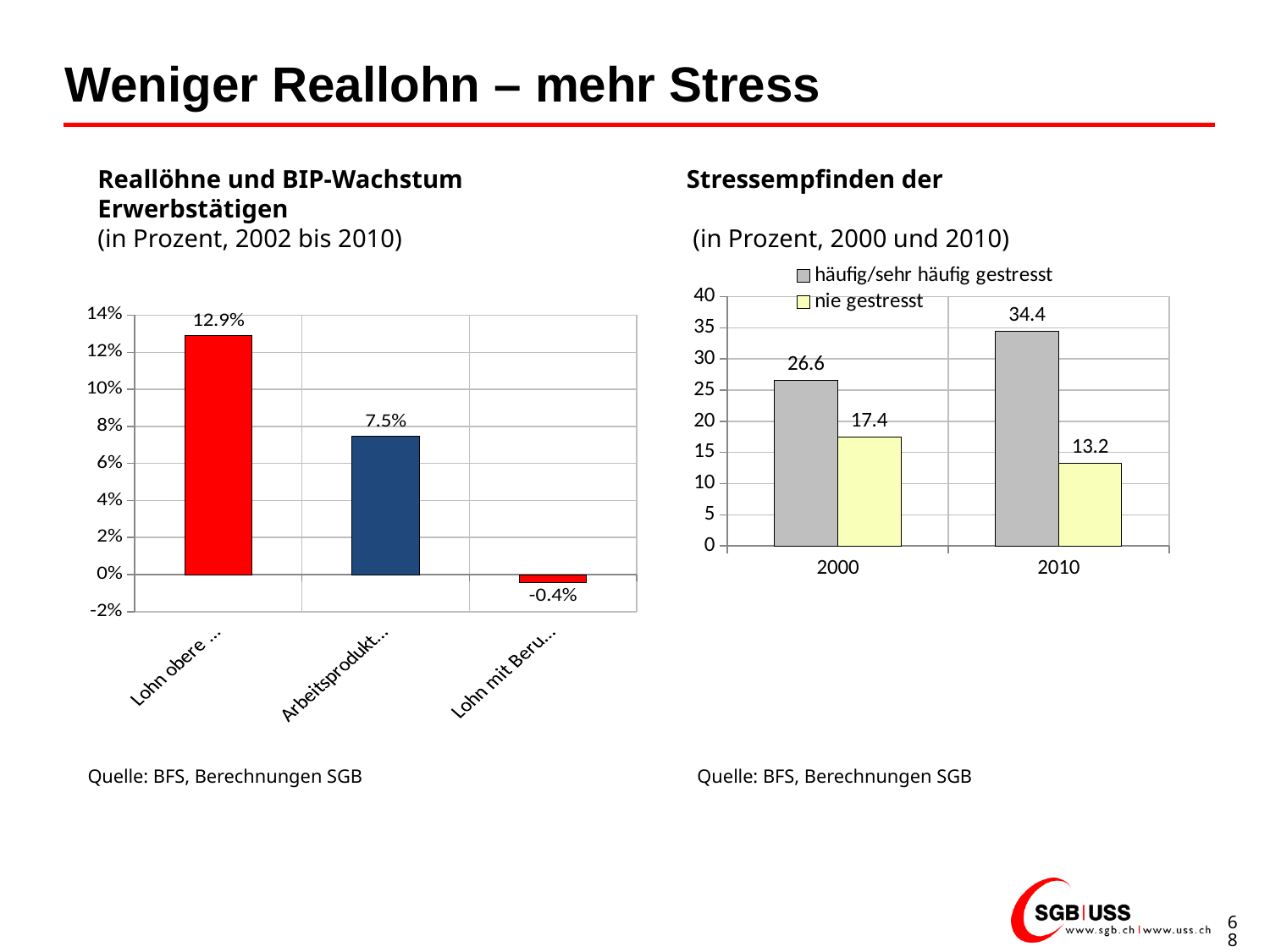
In the left chart (Reallöhne und BIP-Wachstum), what is the difference between the first bar (12.9%) and the middle bar (7.5%)? 5.4% What type of chart is the right chart (Stressempfinden der Erwerbstätigen)? bar chart In the right chart (Stressempfinden der Erwerbstätigen), does the 'nie gestresst' series rise or fall from 2000 to 2010? fall In the left chart (Reallöhne und BIP-Wachstum), what is the value of the first (red) bar? 12.9% In the left chart (Reallöhne und BIP-Wachstum), how many bars are plotted? 3 In the right chart (Stressempfinden der Erwerbstätigen), by how much did 'häufig/sehr häufig gestresst' change from 2000 to 2010? 7.8 In the right chart (Stressempfinden der Erwerbstätigen), how many series does the legend list? 2 In the right chart (Stressempfinden der Erwerbstätigen), what is the value for 'nie gestresst' in 2000? 17.4 In the left chart (Reallöhne und BIP-Wachstum), what is the value of the third bar on the right? -0.4% In the right chart (Stressempfinden der Erwerbstätigen), what is the value for 'häufig/sehr häufig gestresst' in 2010? 34.4 In the left chart (Reallöhne und BIP-Wachstum), what is the value of the middle (blue) bar? 7.5% In the right chart (Stressempfinden der Erwerbstätigen), which is larger in 2010: 'häufig/sehr häufig gestresst' or 'nie gestresst'? häufig/sehr häufig gestresst